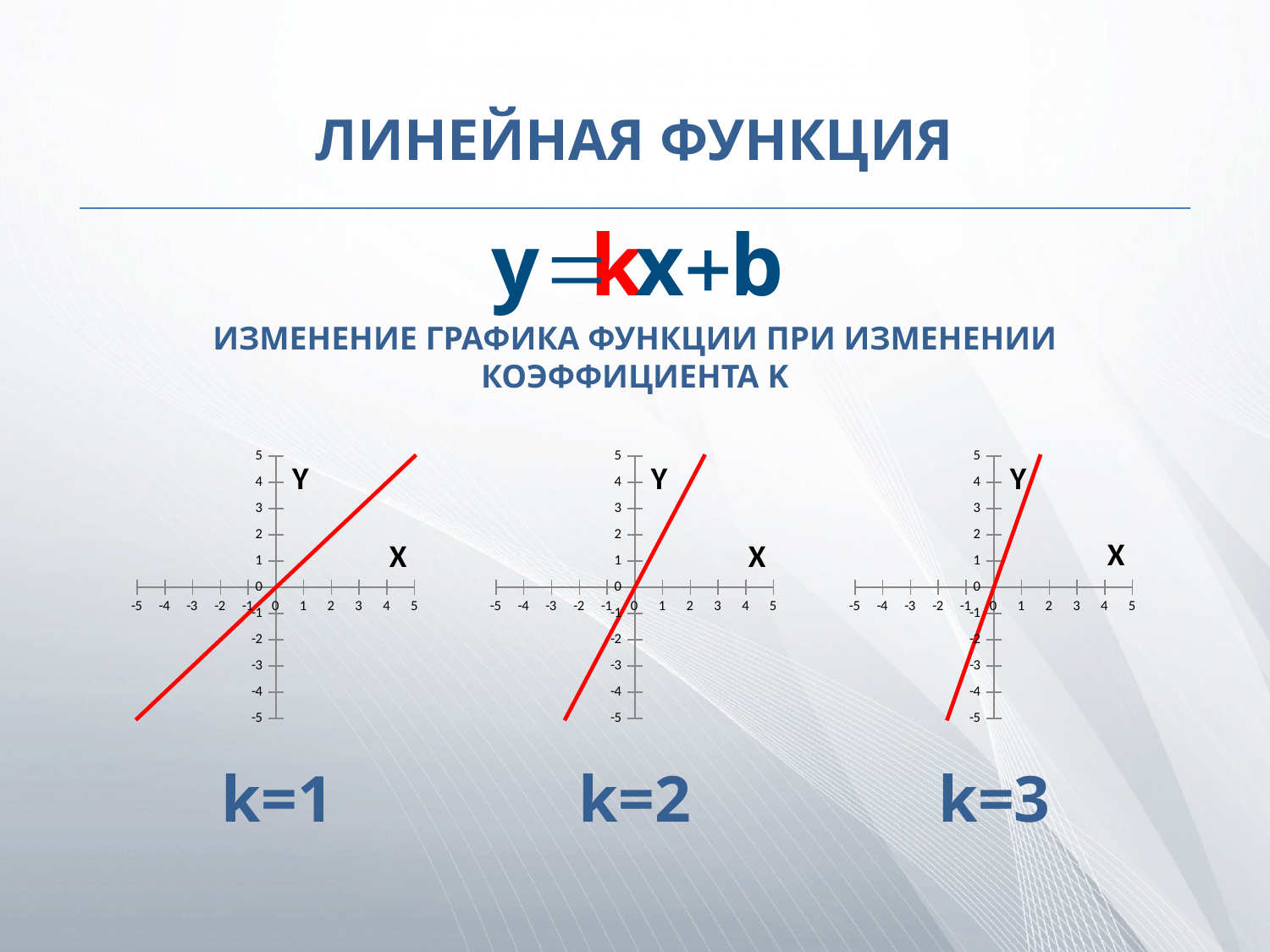
What kind of chart is the k=1 chart? line chart Is the red line in the k=1 chart steeper or less steep than the red line in the k=2 chart? less steep Which of the three charts has the steepest red line? k=3 In the k=3 chart, at x = -1, is the value of the red line greater or less than -1? less What is the lowest value shown on the y axis of the k=3 chart? -5 In the k=3 chart, does the red line rise or fall as x increases? rise What labels are given to the horizontal and vertical axes in the k=2 chart? X and Y How many charts are shown on the slide? 3 In the k=1 chart, does the red line rise or fall as x increases? rise In the k=1 chart, at x = 4, is the value of the red line greater or less than 2? greater What colour is the plotted line in each of the three charts? red What is the highest value shown on the x axis of the k=2 chart? 5